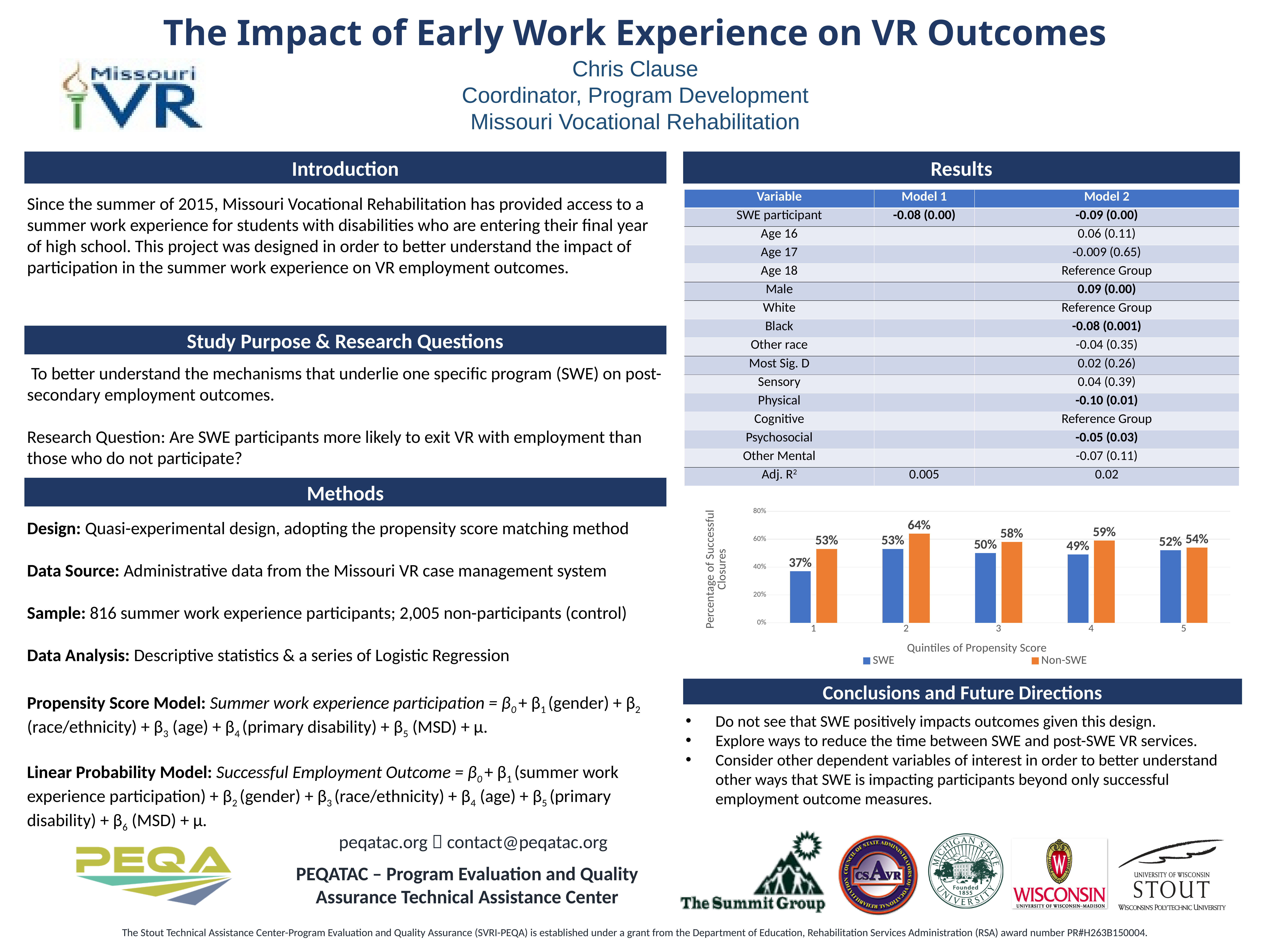
What is the difference between the Non-SWE and SWE values for quintile 1? 16% Which quintile has the highest Non-SWE value? 2 For quintile 3, which is larger, the SWE value or the Non-SWE value? Non-SWE What is the Non-SWE value for quintile 5? 54% Which quintile has the lowest SWE value? 1 What is the x-axis title of the chart? Quintiles of Propensity Score What is the SWE value for quintile 1? 37% How many series does the chart legend list? 2 What is the Non-SWE value for quintile 2? 64% What kind of chart is shown in the Results section? bar chart What is the SWE value for quintile 4? 49% How many quintiles are shown on the x axis of the chart? 5